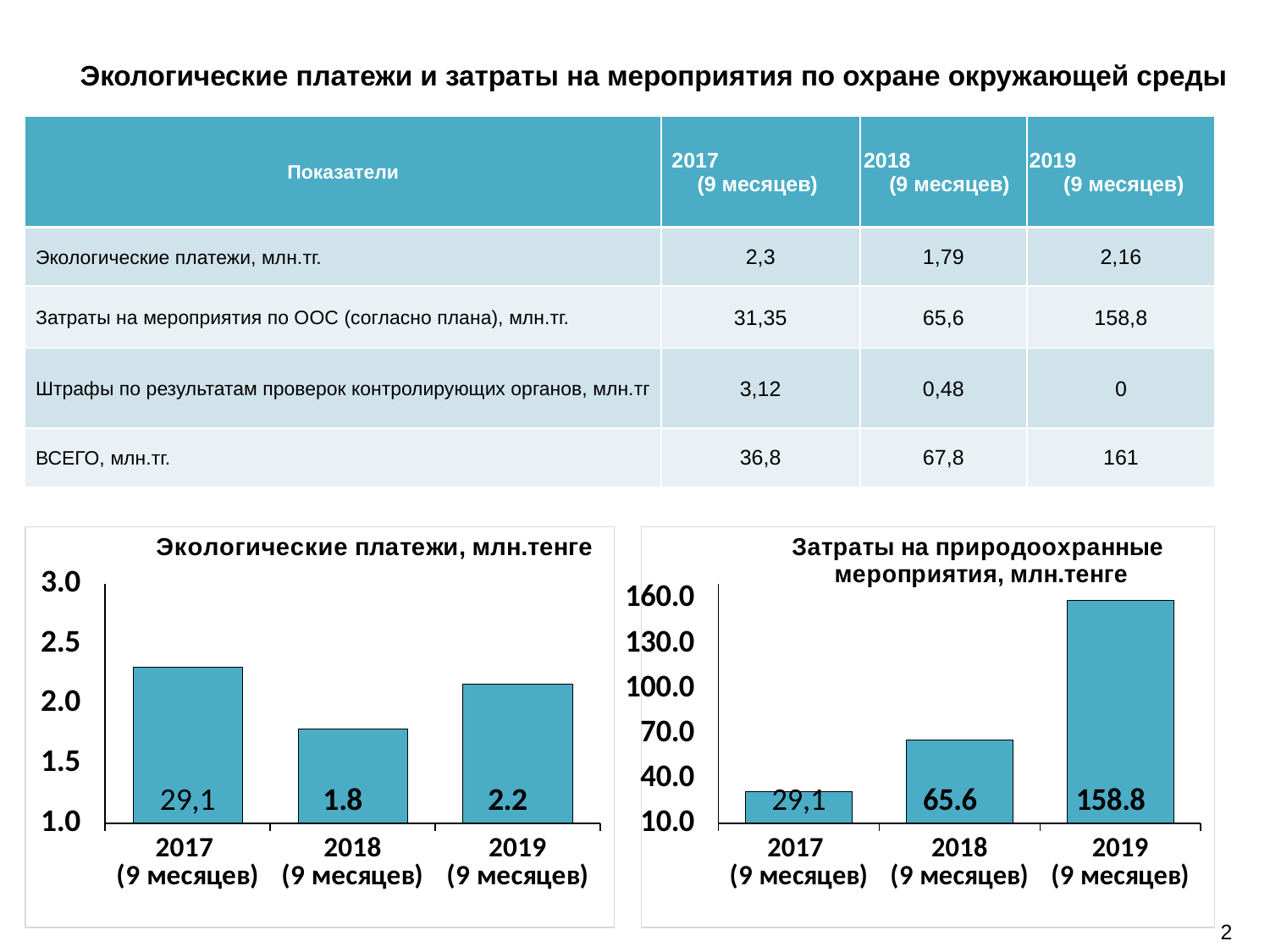
In the left chart "Экологические платежи, млн.тенге", what is the value for 2019 (9 месяцев)? 2.2 What kind of chart is the left chart titled "Экологические платежи, млн.тенге"? bar chart In the right chart "Затраты на природоохранные мероприятия, млн.тенге", what is the value for 2019 (9 месяцев)? 158.8 How many bars are shown in the left chart "Экологические платежи, млн.тенге"? 3 In the left chart "Экологические платежи, млн.тенге", which is larger: the value for 2018 (9 месяцев) or for 2019 (9 месяцев)? 2019 (9 месяцев) In the right chart "Затраты на природоохранные мероприятия, млн.тенге", which period has the highest value? 2019 (9 месяцев) In the left chart "Экологические платежи, млн.тенге", what is the value for 2018 (9 месяцев)? 1.8 In the left chart "Экологические платежи, млн.тенге", which period has the lowest value? 2018 (9 месяцев) In the right chart "Затраты на природоохранные мероприятия, млн.тенге", what is the value for 2018 (9 месяцев)? 65.6 In the left chart "Экологические платежи, млн.тенге", is the bar for 2017 (9 месяцев) greater or less than 2.0? greater In the right chart "Затраты на природоохранные мероприятия, млн.тенге", do the values rise or fall from 2017 to 2019? rise In the right chart "Затраты на природоохранные мероприятия, млн.тенге", what is the difference between the values for 2019 (9 месяцев) and 2018 (9 месяцев)? 93.2